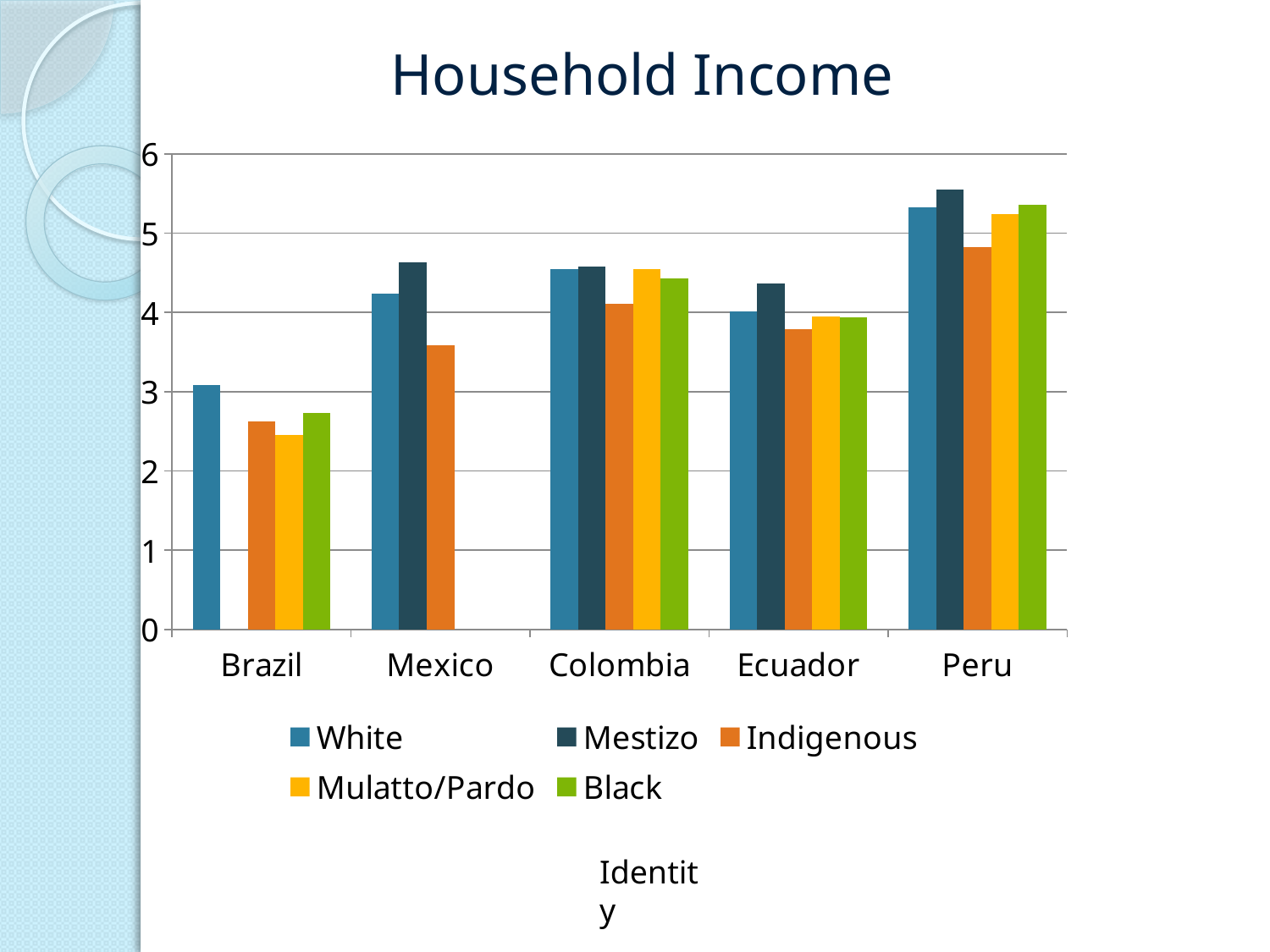
Which country has the lowest value for the White series? Brazil In Peru, which series has the lowest value? Indigenous What is the title of the chart? Household Income How many series does the legend list? 5 Which country has the highest value for the White series? Peru Is the Indigenous value for Mexico greater or less than 4? less Which country has the highest value for the Indigenous series? Peru Is the Mestizo value for Peru greater or less than 5? greater How many countries are shown on the x axis? 5 In Mexico, which is larger, the Mestizo value or the Indigenous value? Mestizo What kind of chart is shown on the slide? bar chart Is the Mulatto/Pardo value for Brazil greater or less than 3? less